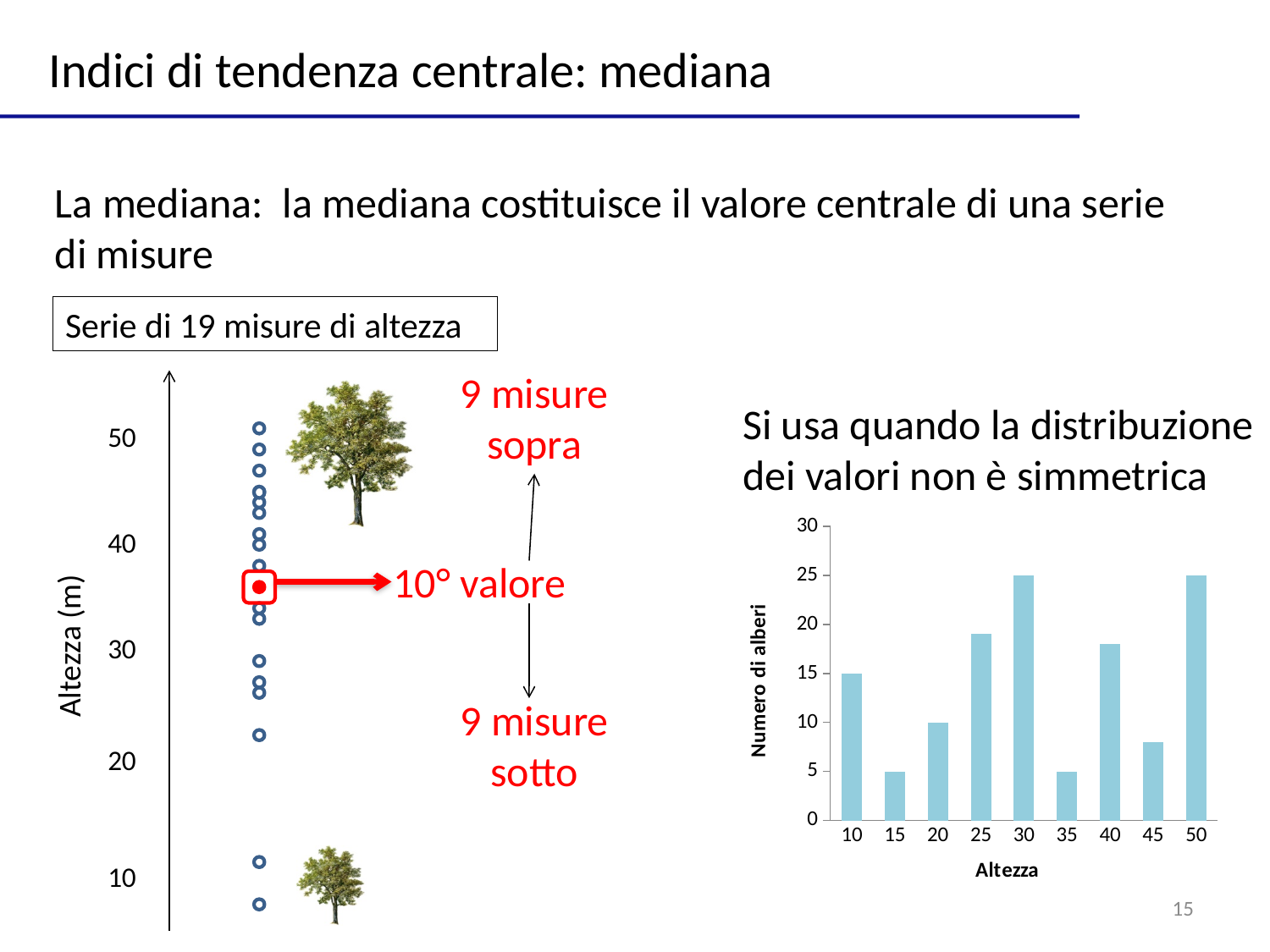
In the bar chart on the right, what is the number of trees for height 35? 5 In the bar chart on the right, which has more trees: height 10 or height 15? 10 What is the title of the vertical axis of the bar chart on the right? Numero di alberi What kind of chart is shown on the right side of the slide? bar chart In the bar chart on the right, what is the difference between the number of trees for height 30 and for height 15? 20 In the bar chart on the right, which has more trees: height 30 or height 25? 30 In the bar chart on the right, what is the number of trees for height 30? 25 In the bar chart on the right, is the value for height 25 greater or less than 15? greater In the bar chart on the right, is the value for height 45 greater or less than 10? less In the bar chart on the right, what is the number of trees (Numero di alberi) for height 10? 15 In the bar chart on the right, what is the number of trees for height 20? 10 In the bar chart on the right, how many height categories are shown on the x axis? 9